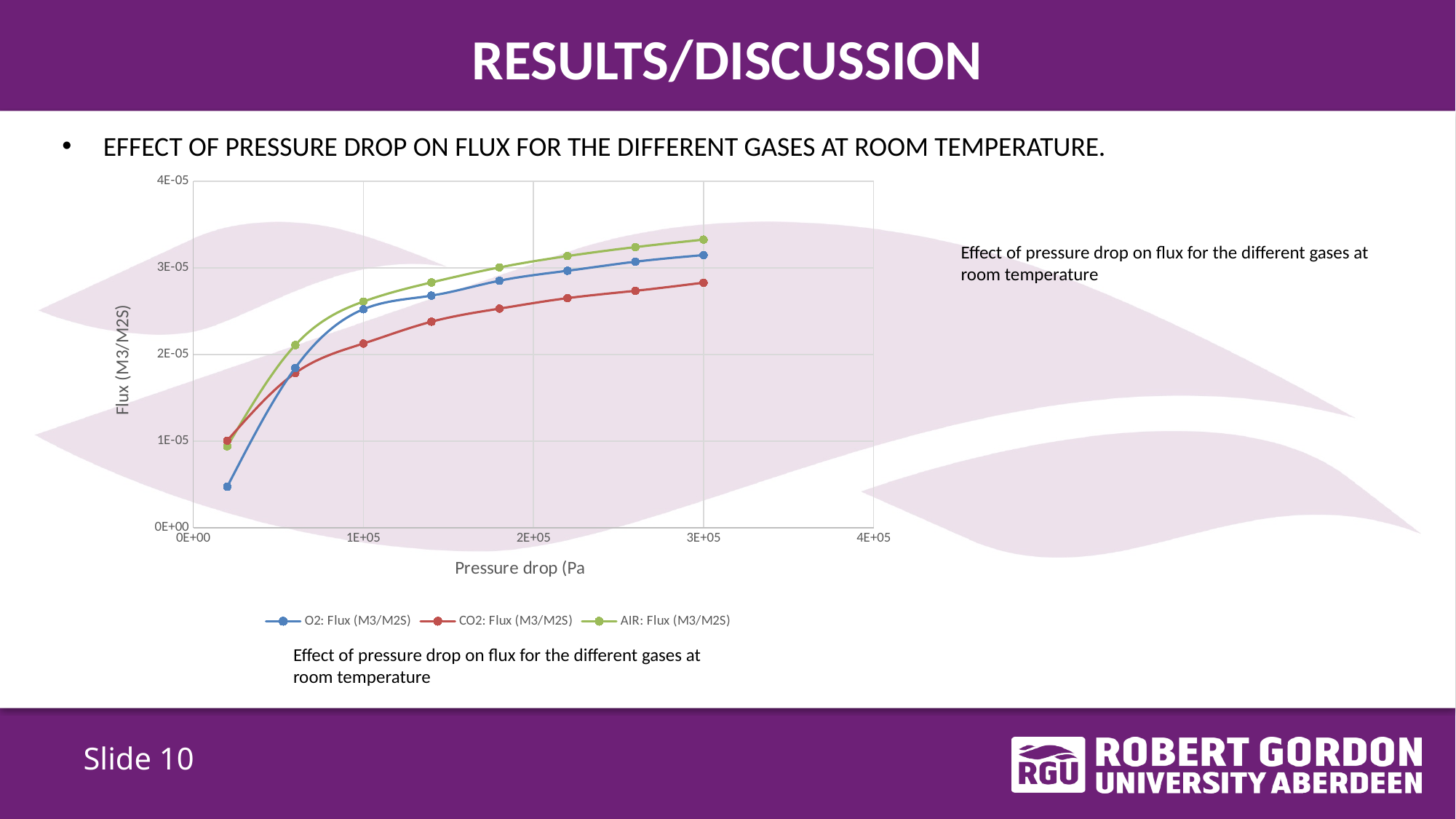
Which series has the lowest flux at the largest pressure drop (3E+05)? CO2: Flux (M3/M2S) At the largest pressure drop (3E+05), is the flux for O2 greater or less than 3E-05? greater How many data points are plotted for the O2: Flux (M3/M2S) series? 8 At the largest pressure drop (3E+05), is the flux for CO2 greater or less than 3E-05? less How many series does the legend list? 3 What kind of chart is shown on the slide? line chart At the smallest pressure drop plotted, is the flux for O2 greater or less than 1E-05? less Which series has the highest flux at the largest pressure drop (3E+05)? AIR: Flux (M3/M2S) What is the title of the y axis? Flux (M3/M2S) Do the flux values rise or fall as pressure drop increases along the x axis? rise What is the title of the x axis? Pressure drop (Pa At the smallest pressure drop plotted, which is larger: the flux for O2 or the flux for CO2? CO2